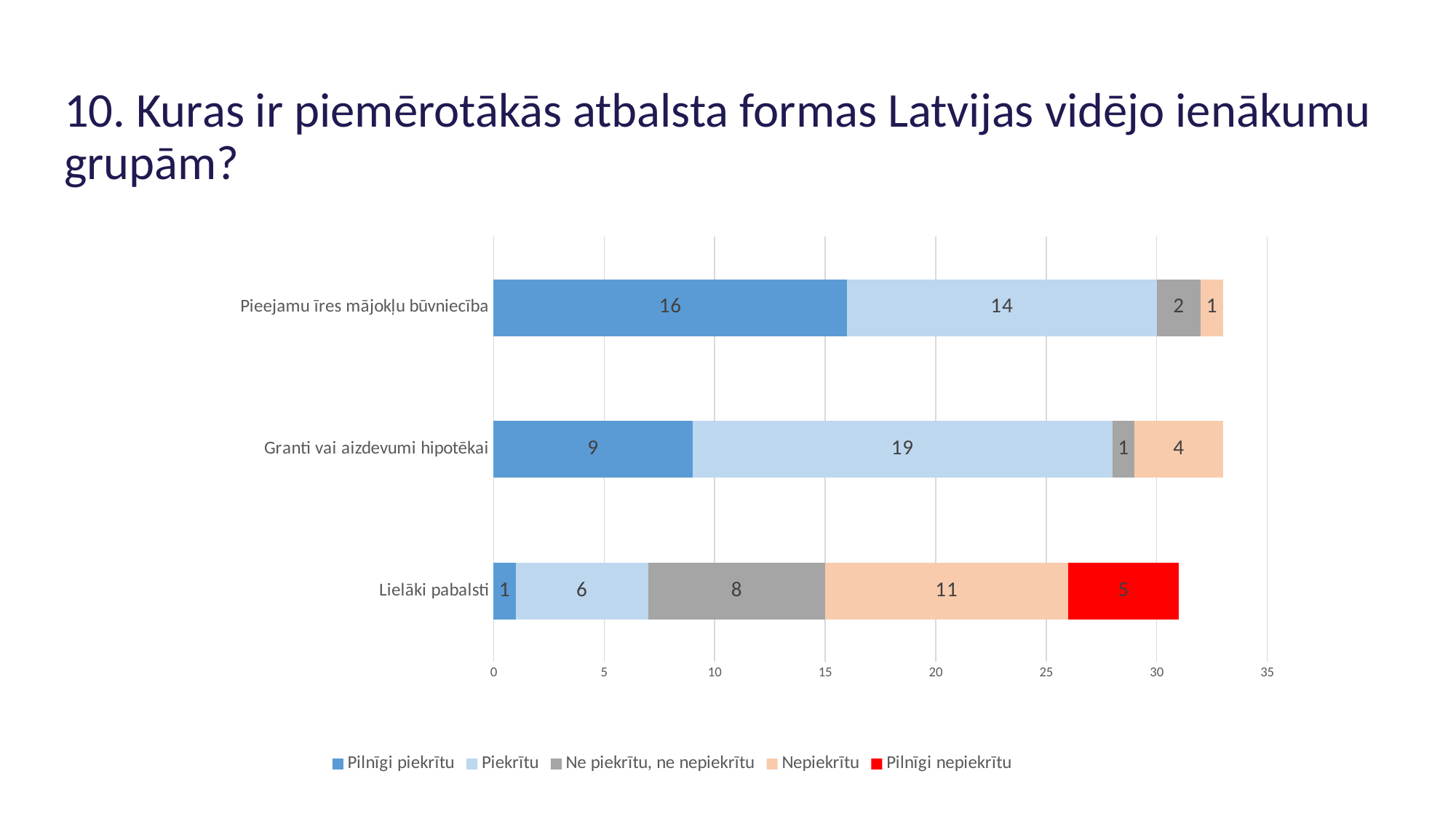
What is the value of "Pilnīgi piekrītu" for "Pieejamu īres mājokļu būvniecība"? 16 Which category is the only one with a "Pilnīgi nepiekrītu" segment? Lielāki pabalsti What is the total of the stacked bar for "Lielāki pabalsti"? 31 Which is larger: the "Ne piekrītu, ne nepiekrītu" value for "Lielāki pabalsti" or for "Pieejamu īres mājokļu būvniecība"? Lielāki pabalsti Which category has the lowest "Piekrītu" value? Lielāki pabalsti How many categories are plotted on the chart? 3 What kind of chart is shown on the slide? Stacked bar chart What is the value of "Piekrītu" for "Granti vai aizdevumi hipotēkai"? 19 What is the value of "Nepiekrītu" for "Lielāki pabalsti"? 11 How many series does the legend list? 5 Which category has the highest "Pilnīgi piekrītu" value? Pieejamu īres mājokļu būvniecība What is the difference between the "Piekrītu" values for "Granti vai aizdevumi hipotēkai" and "Pieejamu īres mājokļu būvniecība"? 5